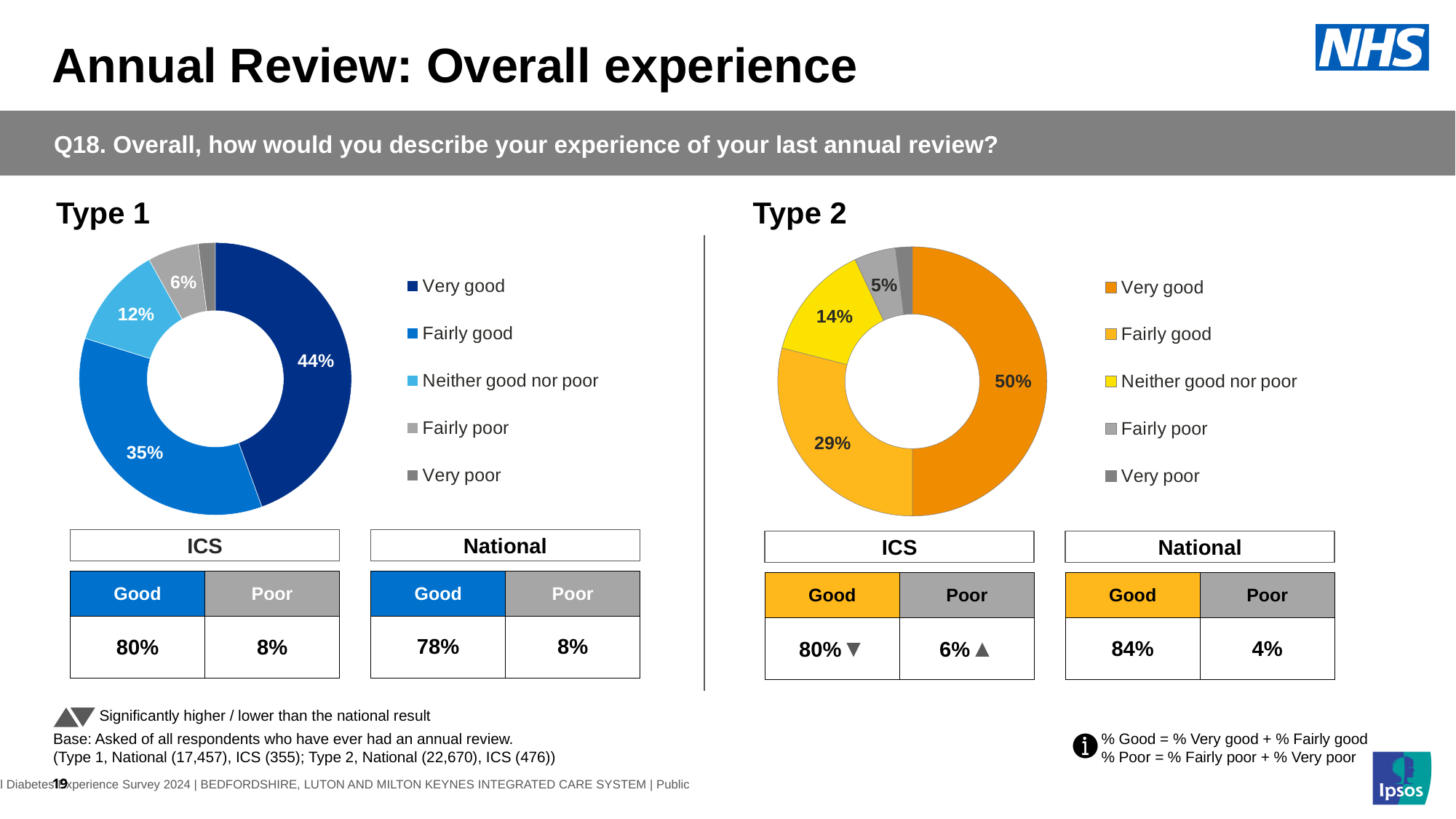
In the Type 1 chart, what percentage of respondents said Fairly good? 35% Which is larger: the Neither good nor poor share in the Type 1 chart or in the Type 2 chart? Type 2 In the Type 2 chart, what percentage of respondents said Fairly poor? 5% In the Type 2 chart, what percentage of respondents said Very good? 50% In the Type 2 chart, what is the difference between the Very good and Fairly good shares? 21 percentage points In the Type 1 chart, what percentage of respondents said their experience was Very good? 44% How many response categories does the legend of the Type 1 chart list? 5 In the Type 2 chart, what percentage of respondents said Neither good nor poor? 14% In the Type 1 chart, which response category has the largest share? Very good In the Type 1 chart, what is the difference between the Very good and Fairly good shares? 9 percentage points In the Type 2 chart, which labelled response category has the smallest share? Fairly poor What kind of chart is used for the Type 2 results? Donut (pie) chart